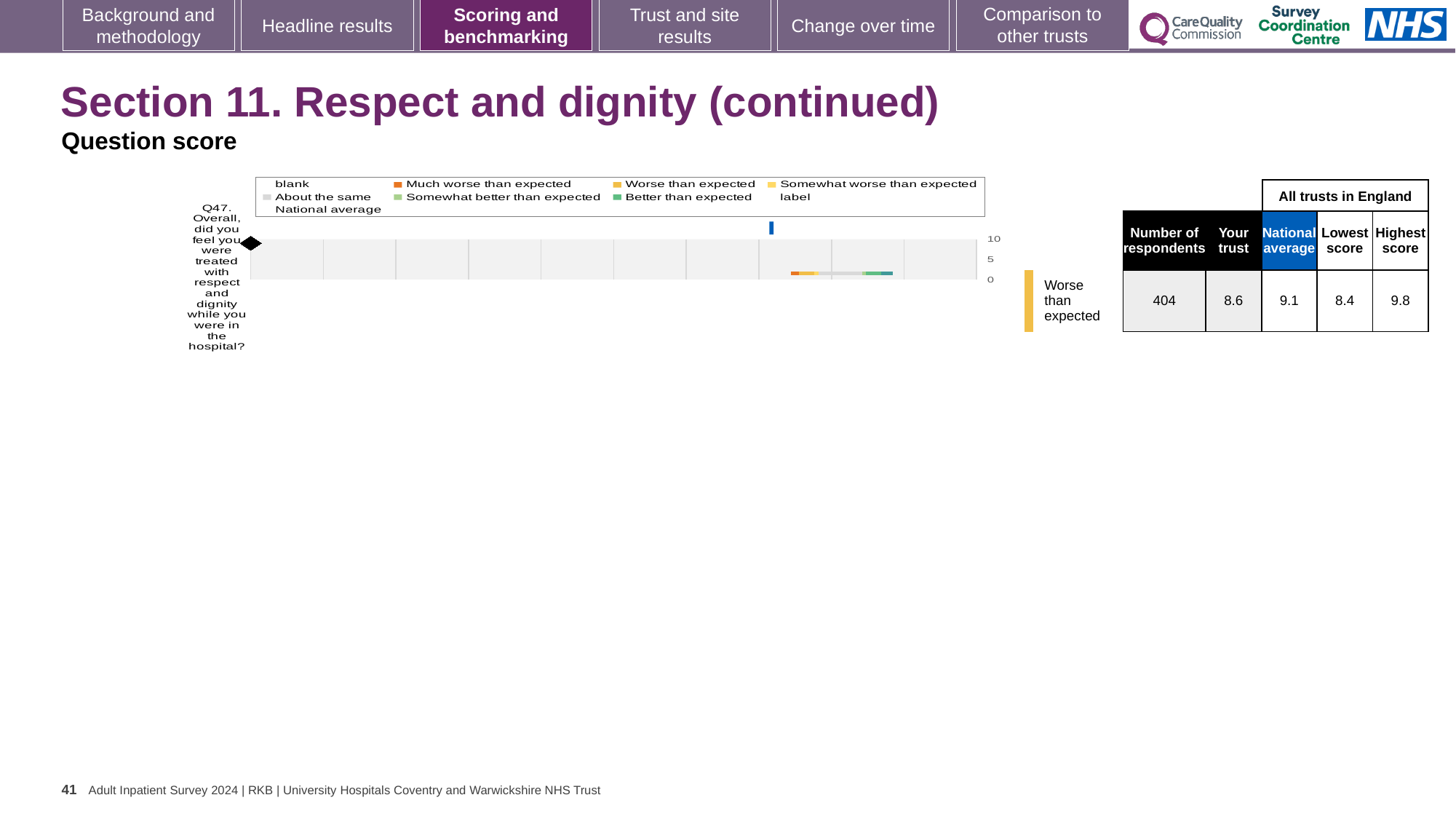
How many questions are plotted on the chart? 1 What is the highest score among all trusts in England for Q47? 9.8 What is the highest tick value shown on the chart's axis? 10 Which question is plotted on the chart? Q47. Overall, did you feel you were treated with respect and dignity while you were in the hospital? How many respondents answered Q47? 404 Which is larger for Q47, the 'Your trust' score or the national average? National average What is the lowest score among all trusts in England for Q47? 8.4 What is the national average score for Q47? 9.1 What benchmarking category is shown for Q47 on the chart? Worse than expected What is the difference between the national average and the 'Your trust' score for Q47? 0.5 What is the 'Your trust' score for Q47? 8.6 What is the difference between the highest and lowest scores among all trusts in England for Q47? 1.4